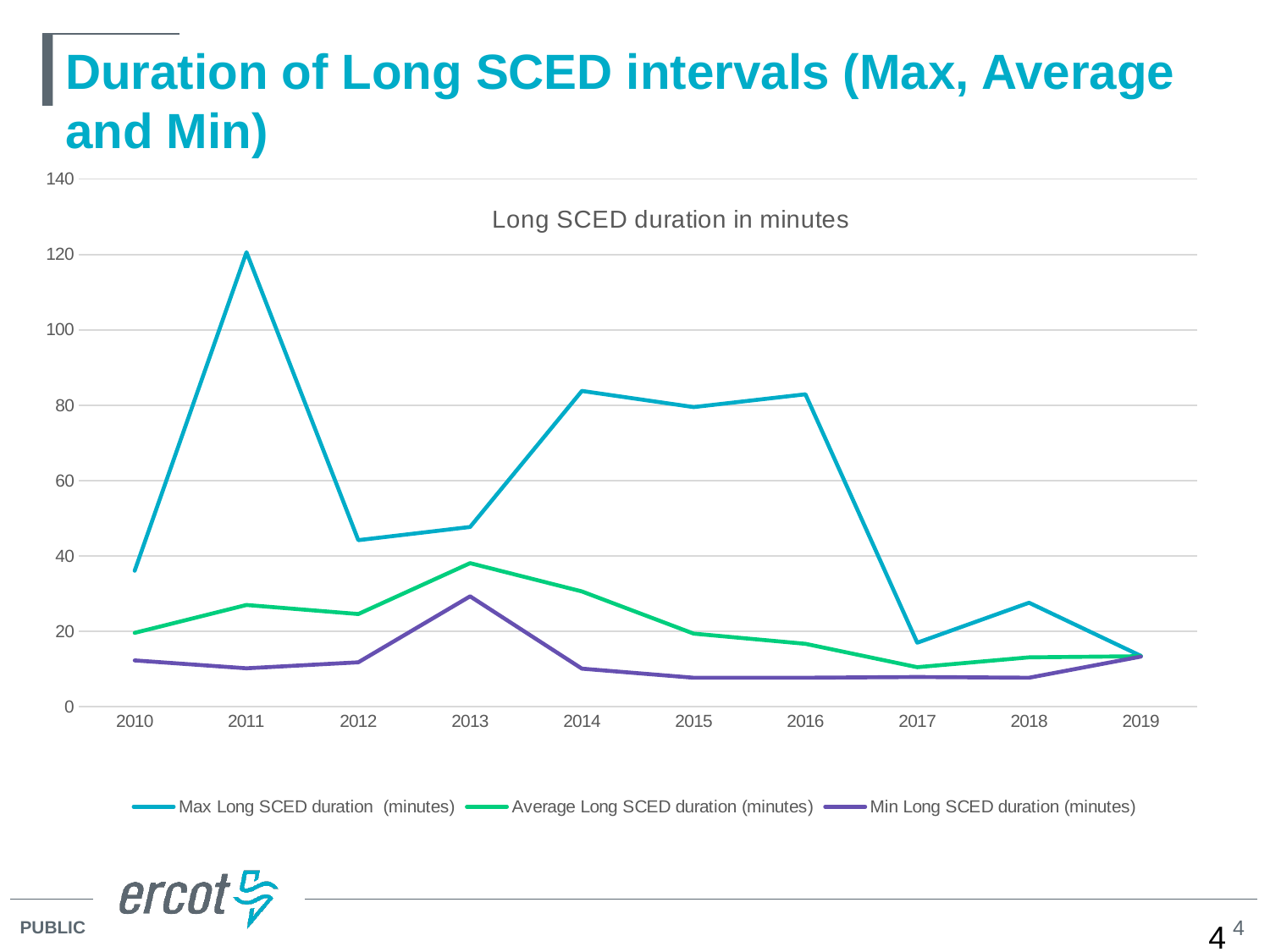
Which is larger, the Max Long SCED duration in 2014 or in 2012? 2014 How many years are plotted along the x axis? 10 What is the title shown inside the chart area? Long SCED duration in minutes Is the Max Long SCED duration for 2017 greater or less than 20? less Is the Average Long SCED duration for 2013 greater or less than 40? less What kind of chart is shown on the slide? line chart In which year is the Average Long SCED duration highest? 2013 Does the Max Long SCED duration rise or fall from 2016 to 2017? fall Is the Max Long SCED duration for 2011 greater or less than 100? greater How many series does the legend list? 3 In which year is the Min Long SCED duration highest? 2013 In which year is the Max Long SCED duration highest? 2011